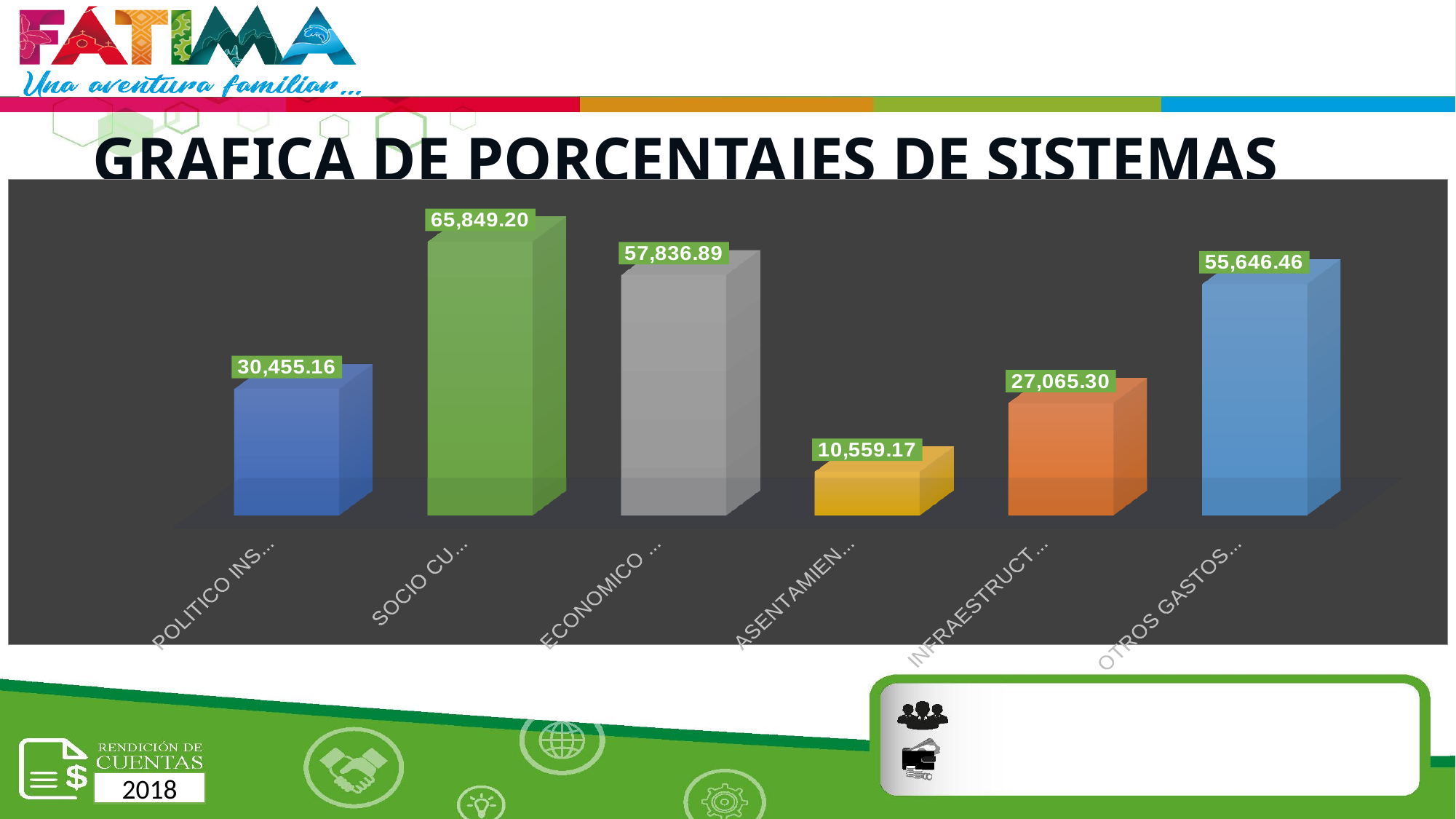
Which is larger, the 'ECONOMICO ...' bar or the 'OTROS GASTOS...' bar? ECONOMICO ... What is the difference between the 'POLITICO INS...' bar and the 'INFRAESTRUCT...' bar? 3,389.86 What is the value of the bar labelled 'OTROS GASTOS...'? 55,646.46 What is the value of the bar labelled 'INFRAESTRUCT...'? 27,065.30 Which category has the highest value? SOCIO CU... What is the value of the bar labelled 'ASENTAMIEN...'? 10,559.17 Which category has the lowest value? ASENTAMIEN... What is the value of the bar labelled 'SOCIO CU...'? 65,849.20 What is the value of the bar labelled 'POLITICO INS...'? 30,455.16 What is the difference between the 'SOCIO CU...' bar and the 'ECONOMICO ...' bar? 8,012.31 How many bars are shown in the chart? 6 What kind of chart is shown on the slide? Bar chart